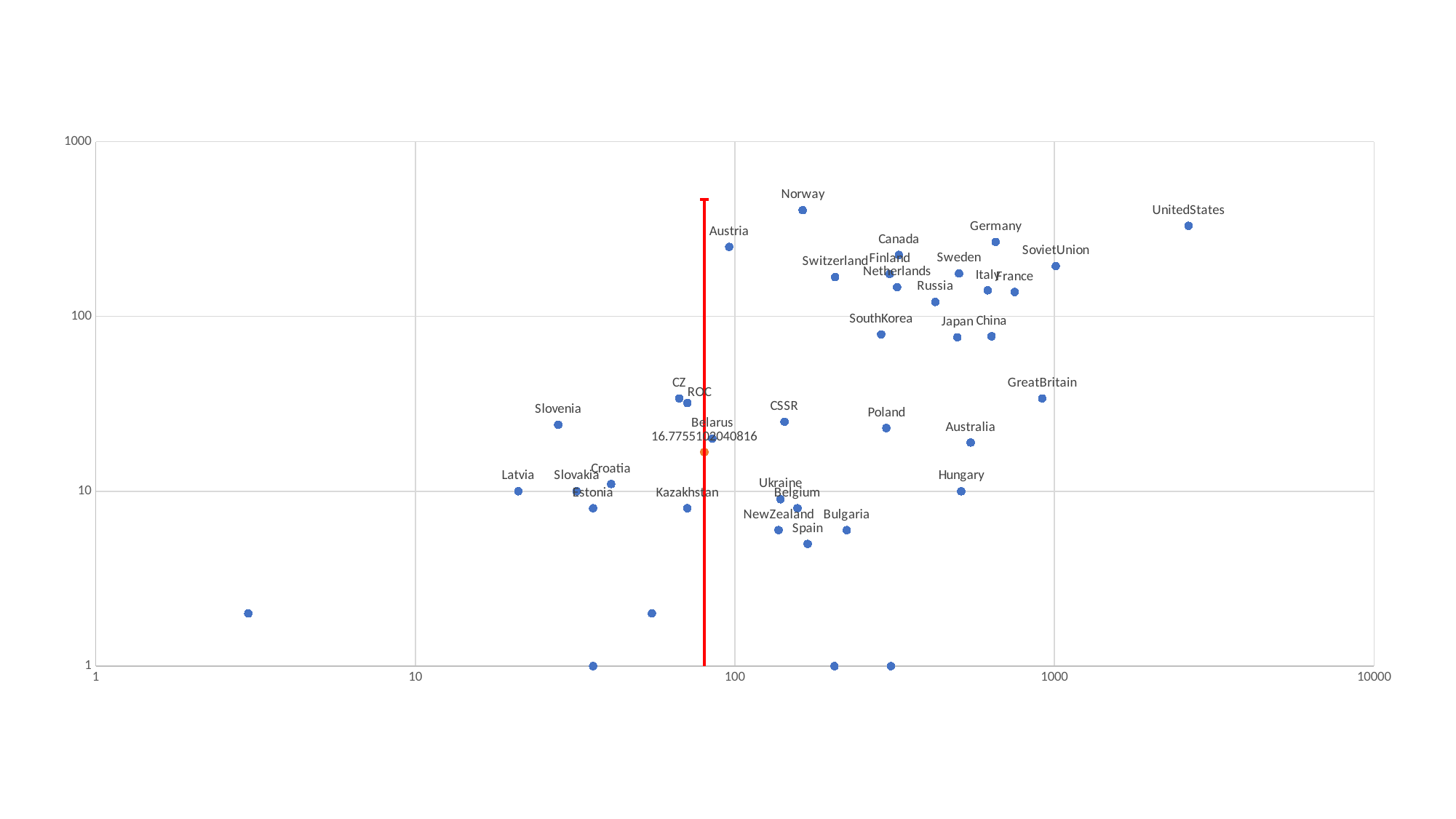
Is the horizontal-axis value for UnitedStates greater or less than 1000? greater Which labeled point has the lowest vertical-axis value? Spain Which labeled point has the highest vertical-axis value? Norway Which has the higher vertical-axis value, Norway or Austria? Norway Which has the higher vertical-axis value, Slovenia or Croatia? Slovenia Is the vertical-axis value for Kazakhstan greater or less than 10? less What kind of chart is shown on the slide? scatter chart Which labeled point has the highest horizontal-axis value? UnitedStates What value is printed next to the orange point? 16.7755102040816 Is the vertical-axis value for Switzerland greater or less than 100? greater What colour is the vertical line drawn on the chart? red Which labeled point is furthest left on the horizontal axis? Latvia